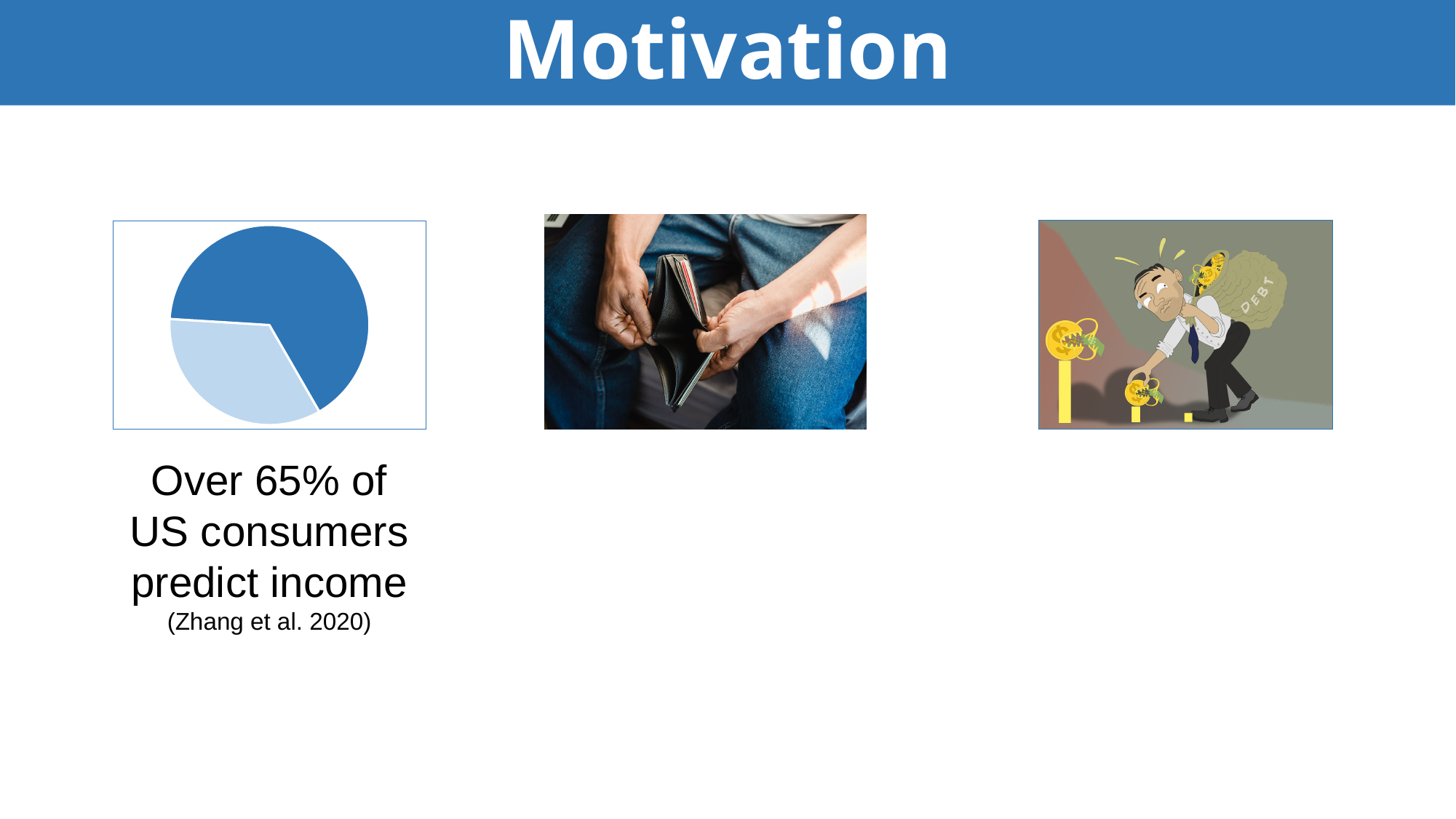
How many slices does the pie chart have? 2 What two colours are used for the slices of the pie chart? dark blue and light blue Which slice of the pie chart is larger, the dark blue one or the light blue one? dark blue Does the dark blue slice of the pie chart take up more or less than half of the pie? more What kind of chart is shown on the left of the slide? pie chart Does the pie chart display a legend? No Does the light blue slice of the pie chart take up more or less than half of the pie? less